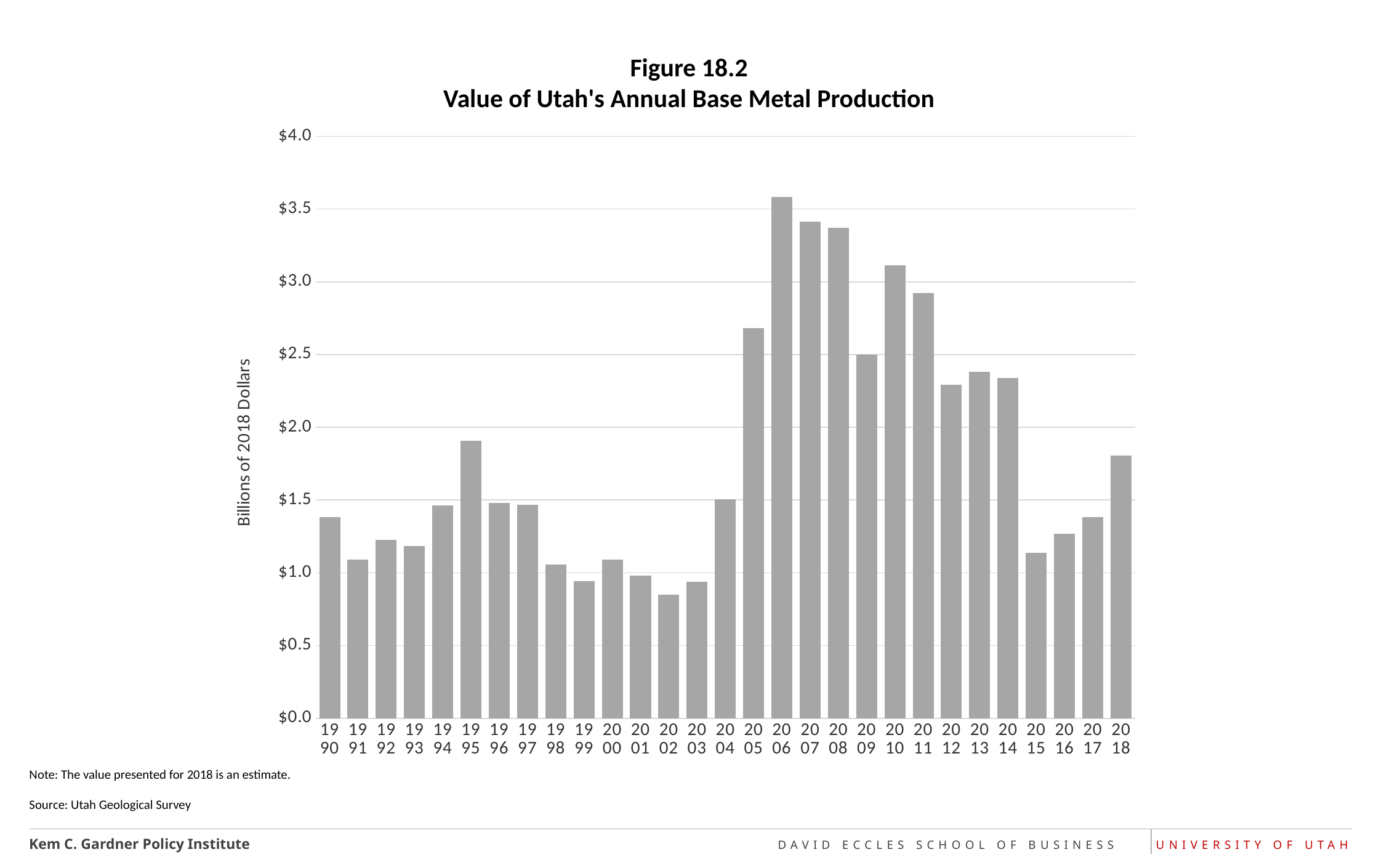
Do the values rise or fall from 2015 to 2018? rise Is the value for 2006 greater or less than $3.5? greater Which year has the lowest value of Utah's annual base metal production? 2002 Which year has the highest value of Utah's annual base metal production? 2006 Is the value for 2018 greater or less than $2.0? less What is the label on the vertical axis of the chart? Billions of 2018 Dollars What kind of chart is shown on the slide? bar chart Is the value for 2005 greater or less than $2.5? greater Which year has the larger value, 2015 or 2016? 2016 How many years are plotted on the chart? 29 Which year has the larger value, 2006 or 2007? 2006